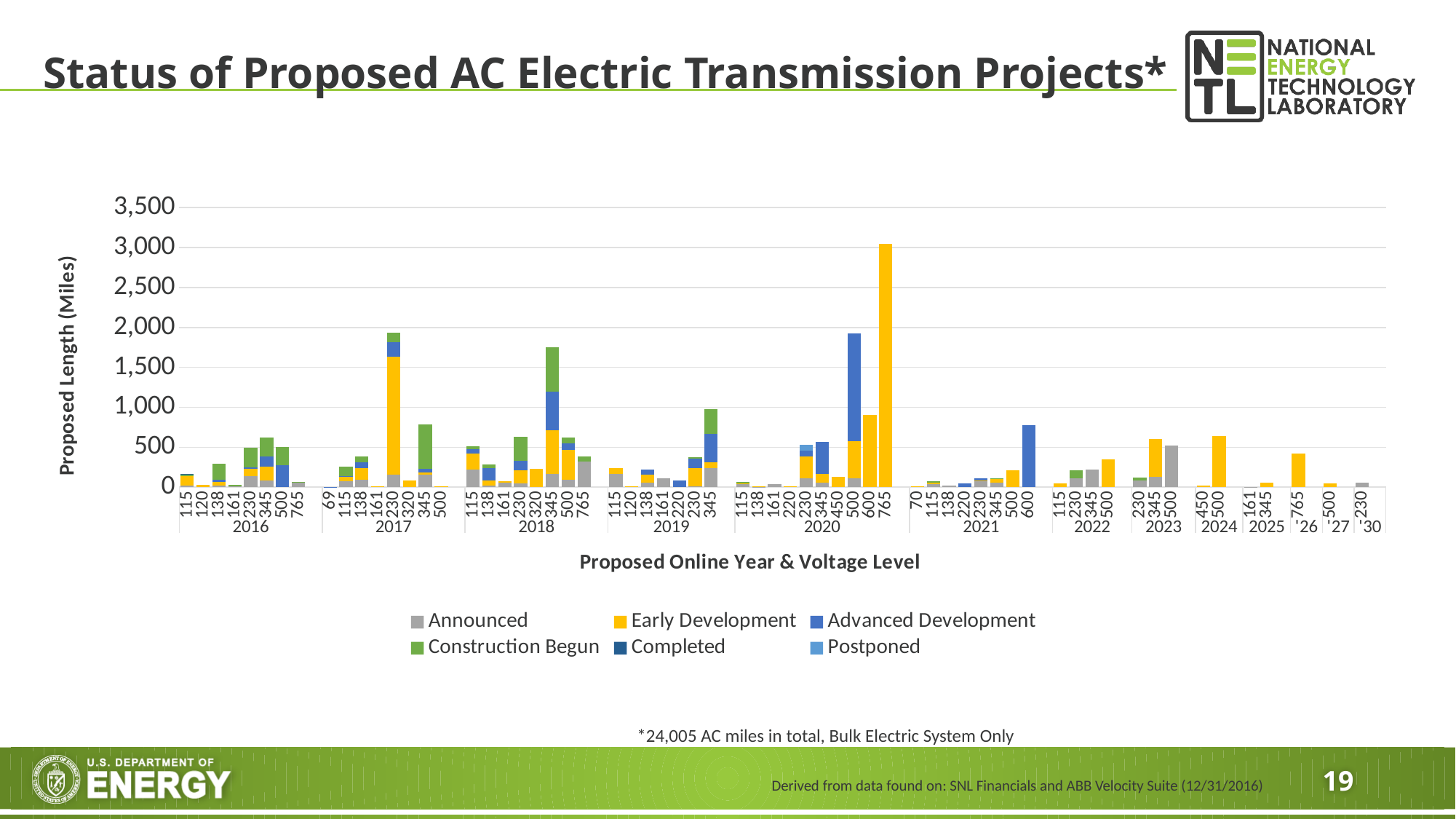
Which legend series is shown in yellow? Early Development How many series does the legend list? 6 Which is taller: the 345 kV bar in 2018 or the 600 kV bar in 2021? 345 kV bar in 2018 Which year and voltage level has the tallest bar in the chart? 2020, 765 How many voltage-level bars are shown for 2016? 8 Is the value for the 600 kV bar in 2021 greater or less than 1,000? less Is the value for the 500 kV bar in 2022 greater or less than 500? less What kind of chart is shown on the slide? Stacked bar chart Is the value for the 230 kV bar in 2017 greater or less than 1,500? greater Within the 2019 group, which voltage level has the tallest bar? 345 What is the title of the vertical axis? Proposed Length (Miles)